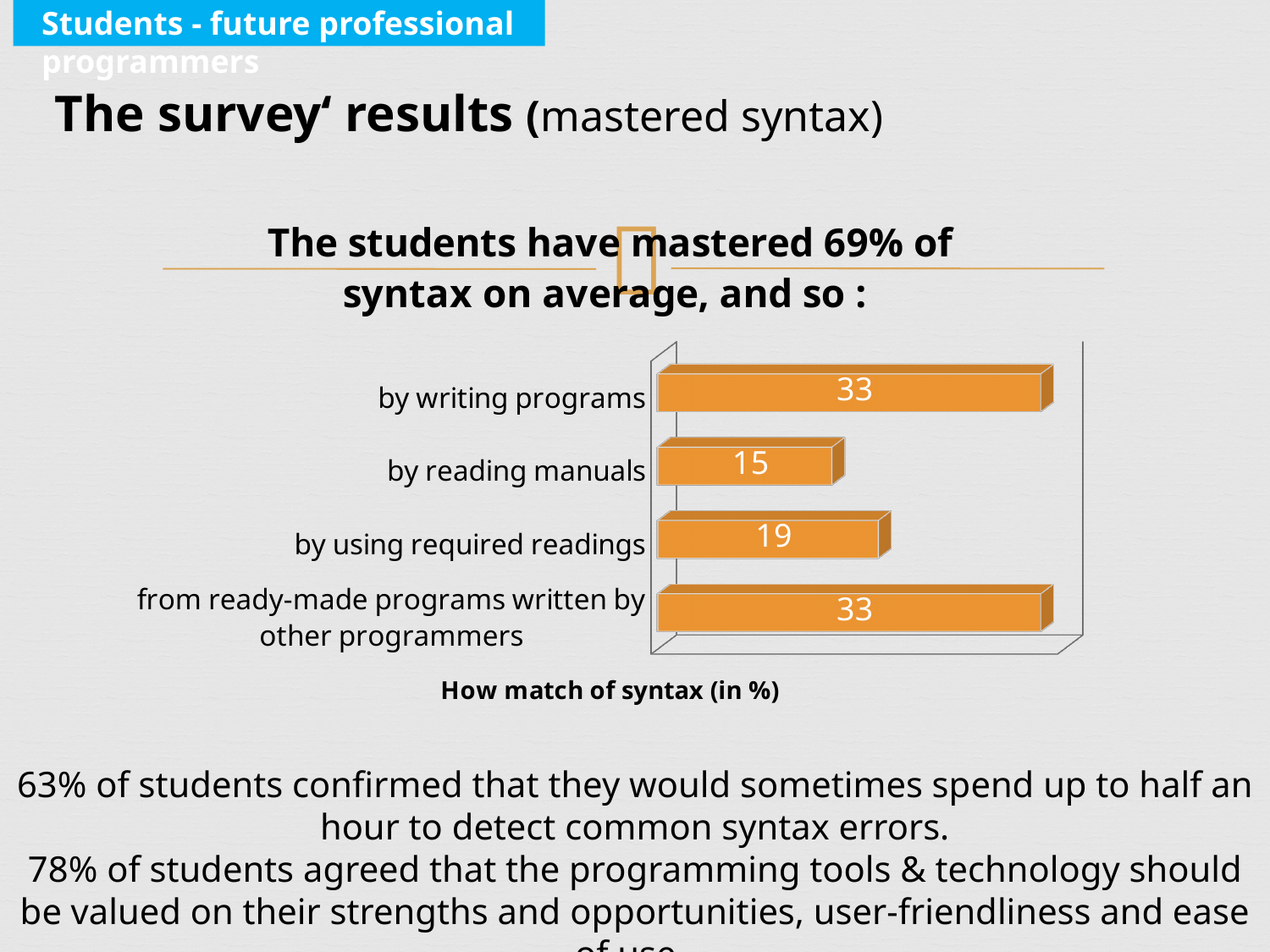
What kind of chart is shown on the slide? bar chart What is the difference between the values for "by writing programs" and "by reading manuals"? 18 Which is larger, the value for "by writing programs" or the value for "by using required readings"? by writing programs What is the value for "by writing programs"? 33 Which is larger, the value for "by using required readings" or the value for "by reading manuals"? by using required readings What is the value for "from ready-made programs written by other programmers"? 33 What is the difference between the values for "by using required readings" and "by reading manuals"? 4 What is the axis title shown below the chart? How match of syntax (in %) What is the value for "by using required readings"? 19 How many categories are shown in the chart? 4 What is the value for "by reading manuals"? 15 Which category has the lowest value? by reading manuals